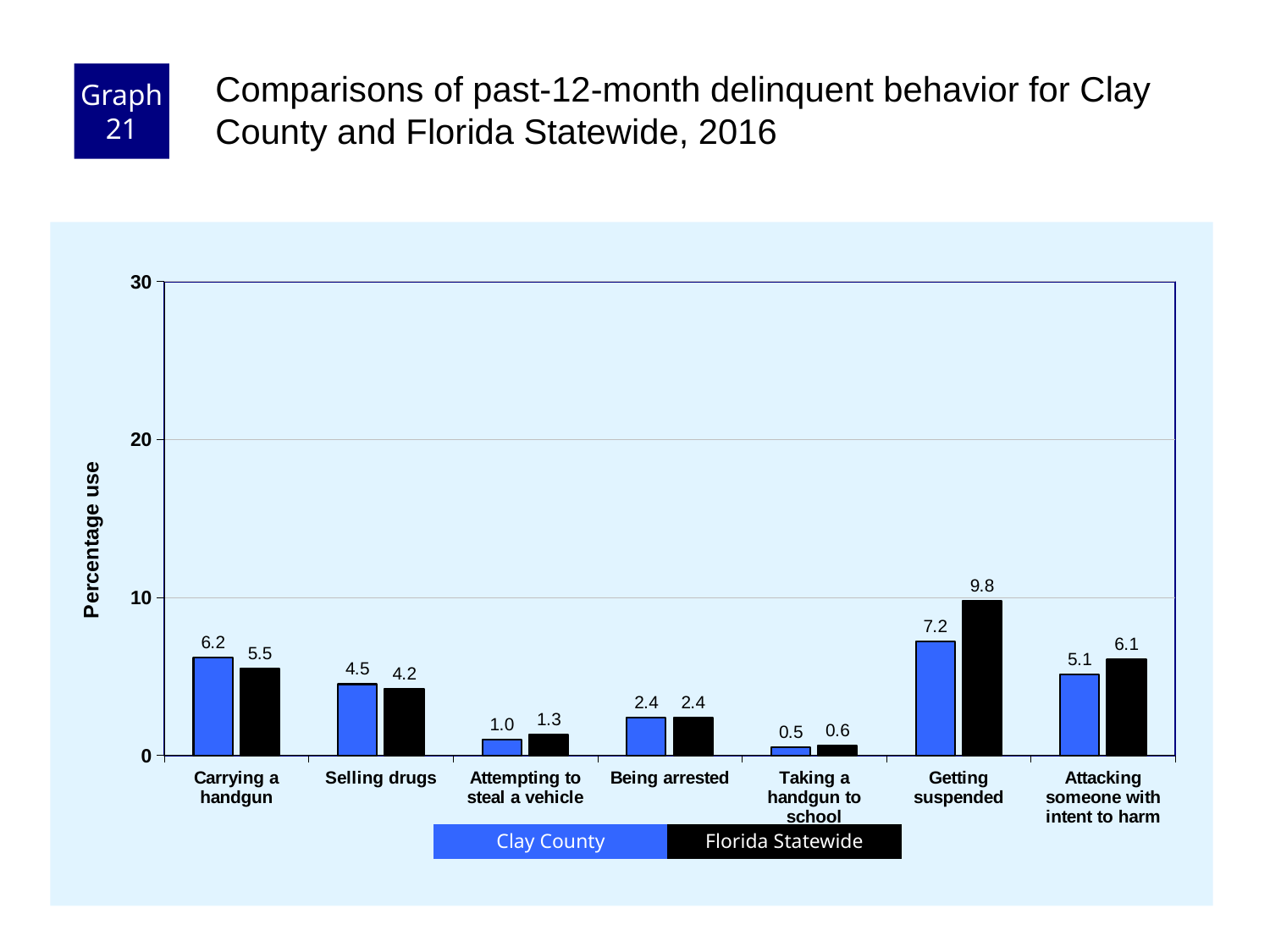
Which is larger for Selling drugs, the Clay County value or the Florida Statewide value? Clay County What is the Clay County value for Taking a handgun to school? 0.5 How many series does the legend list? 2 Is the Florida Statewide value for Getting suspended greater or less than 10? less Which category has the lowest Clay County value? Taking a handgun to school How many behavior categories are shown on the x axis? 7 What is the difference between the Florida Statewide and Clay County values for Getting suspended? 2.6 What kind of chart is shown on the slide? bar chart Which category has the highest Florida Statewide value? Getting suspended What is the Florida Statewide value for Carrying a handgun? 5.5 What is the Clay County value for Getting suspended? 7.2 What is the label of the y axis? Percentage use